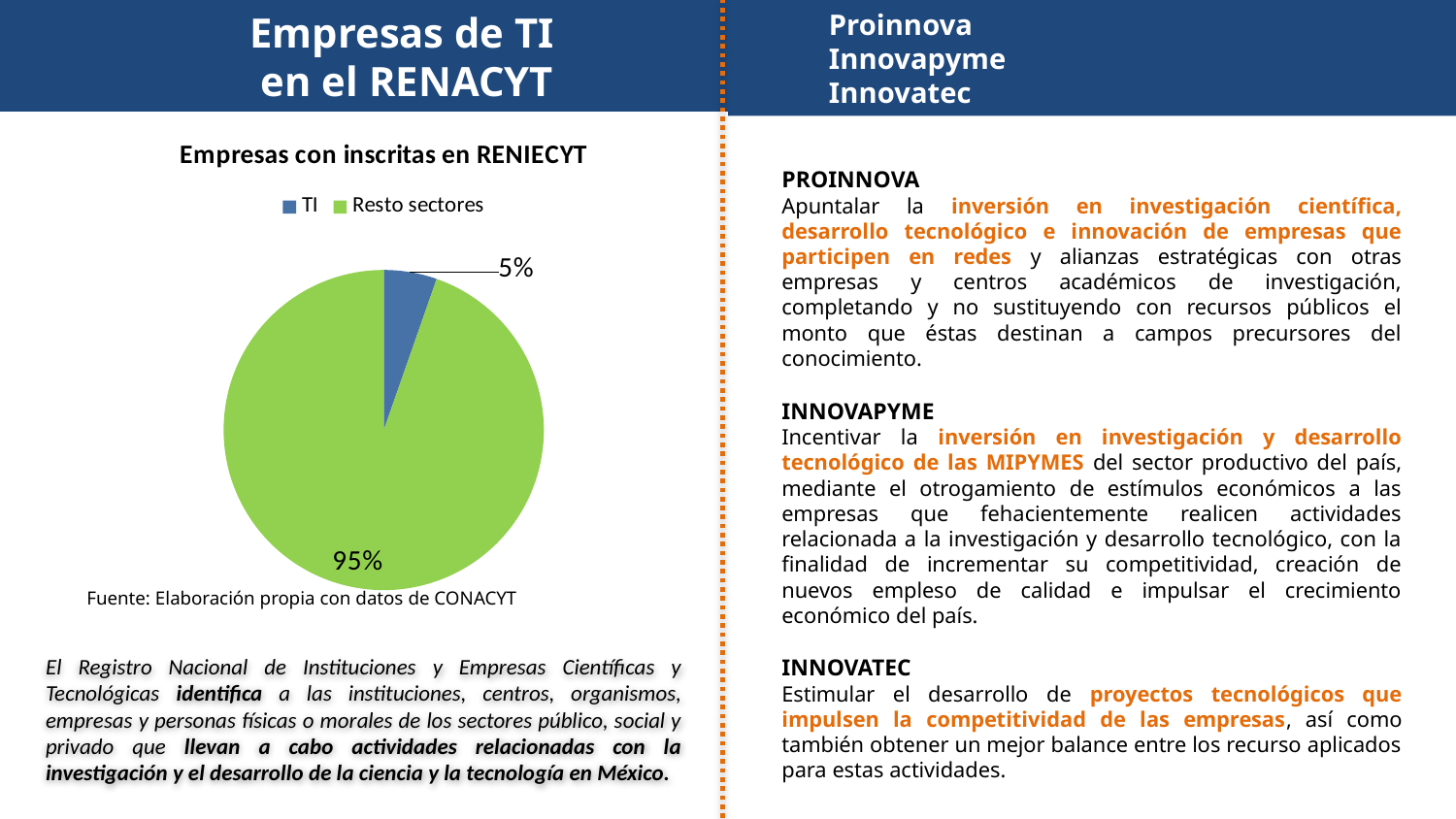
What share of the pie does TI represent? 5% What is the difference in percentage points between Resto sectores and TI? 90 How many slices does the pie chart have? 2 What kind of chart is shown on the slide? Pie chart What share of the pie does Resto sectores represent? 95% Which is larger, the share for TI or the share for Resto sectores? Resto sectores What colour is the TI slice in the pie chart? Blue Which category has the smallest slice of the pie? TI Which category has the largest slice of the pie? Resto sectores How many entries does the chart legend list? 2 What is the source cited below the chart? Elaboración propia con datos de CONACYT What is the title of the chart? Empresas con inscritas en RENIECYT